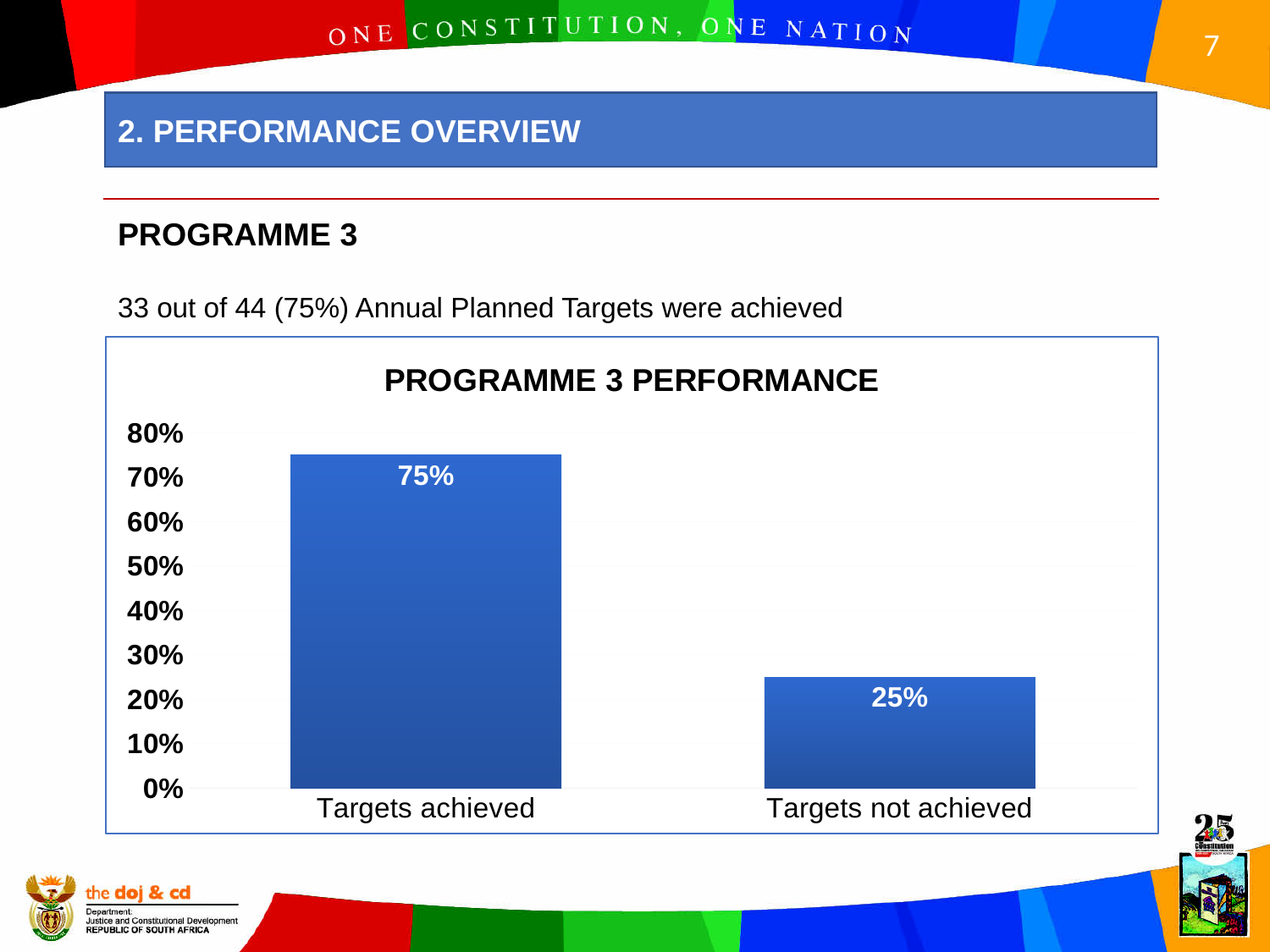
What kind of chart is shown? bar chart Which is larger, Targets achieved or Targets not achieved? Targets achieved What is the value for Targets not achieved? 25% What is the title of the chart? PROGRAMME 3 PERFORMANCE What is the highest value shown on the y axis? 80% What is the difference between the values for Targets achieved and Targets not achieved? 50% Which category has the lowest value? Targets not achieved Is the value for Targets achieved greater or less than 60%? greater How many categories are shown in the chart? 2 What is the value for Targets achieved? 75% Which category has the highest value? Targets achieved Is the value for Targets not achieved greater or less than 30%? less